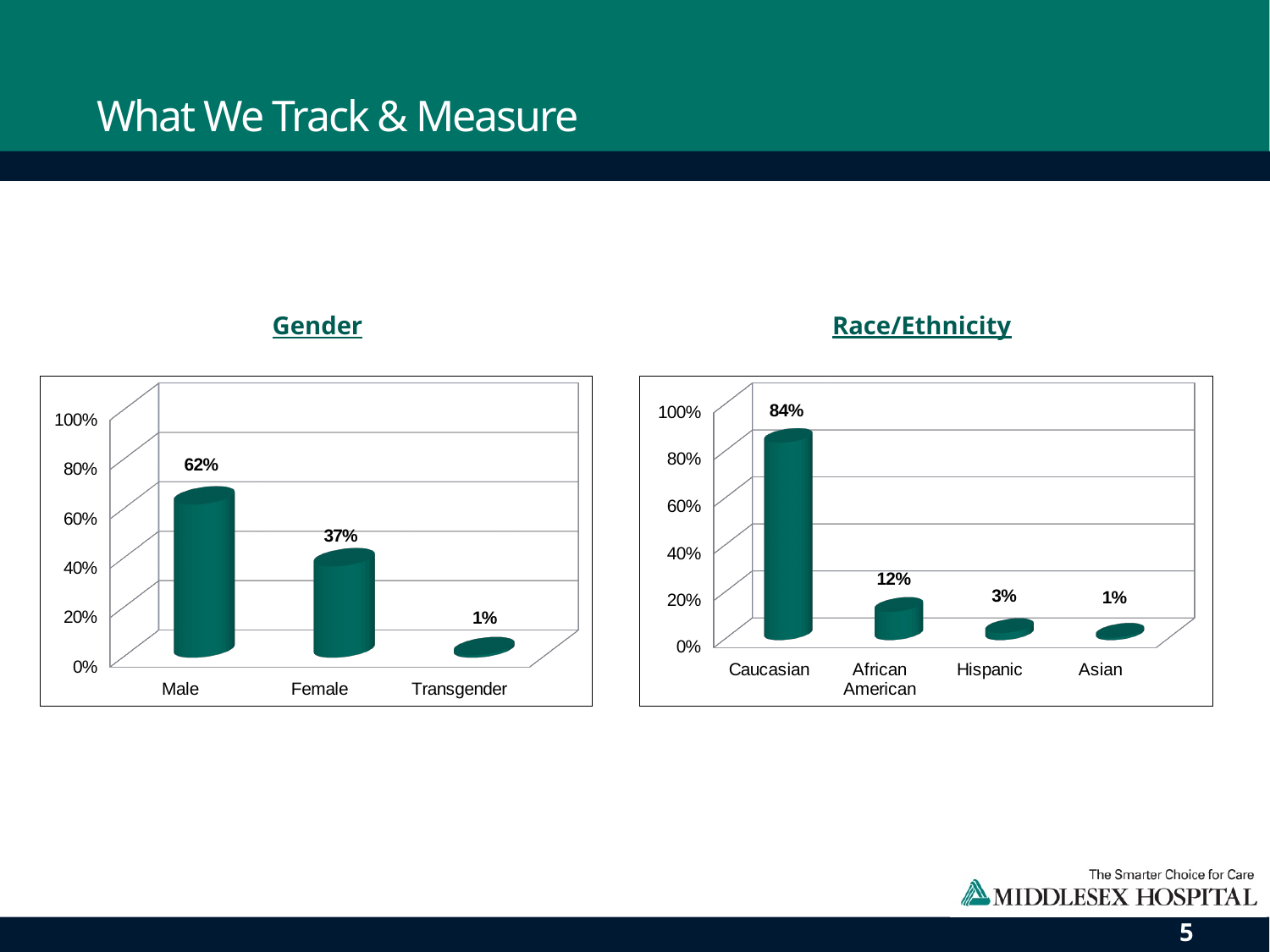
In the Gender chart, what is the value for Female? 37% In the Gender chart, what is the difference between the Male and Female values? 25% In the Gender chart, which category has the lowest value? Transgender In the Race/Ethnicity chart, what is the value for Caucasian? 84% In the Gender chart, what is the value for Male? 62% In the Gender chart, how many categories are shown? 3 In the Race/Ethnicity chart, which is larger, Hispanic or Asian? Hispanic In the Race/Ethnicity chart, how many categories are shown? 4 In the Race/Ethnicity chart, what is the value for African American? 12% What kind of chart is the Race/Ethnicity chart? Bar chart In the Race/Ethnicity chart, which category has the highest value? Caucasian In the Race/Ethnicity chart, what is the difference between the Caucasian and African American values? 72%